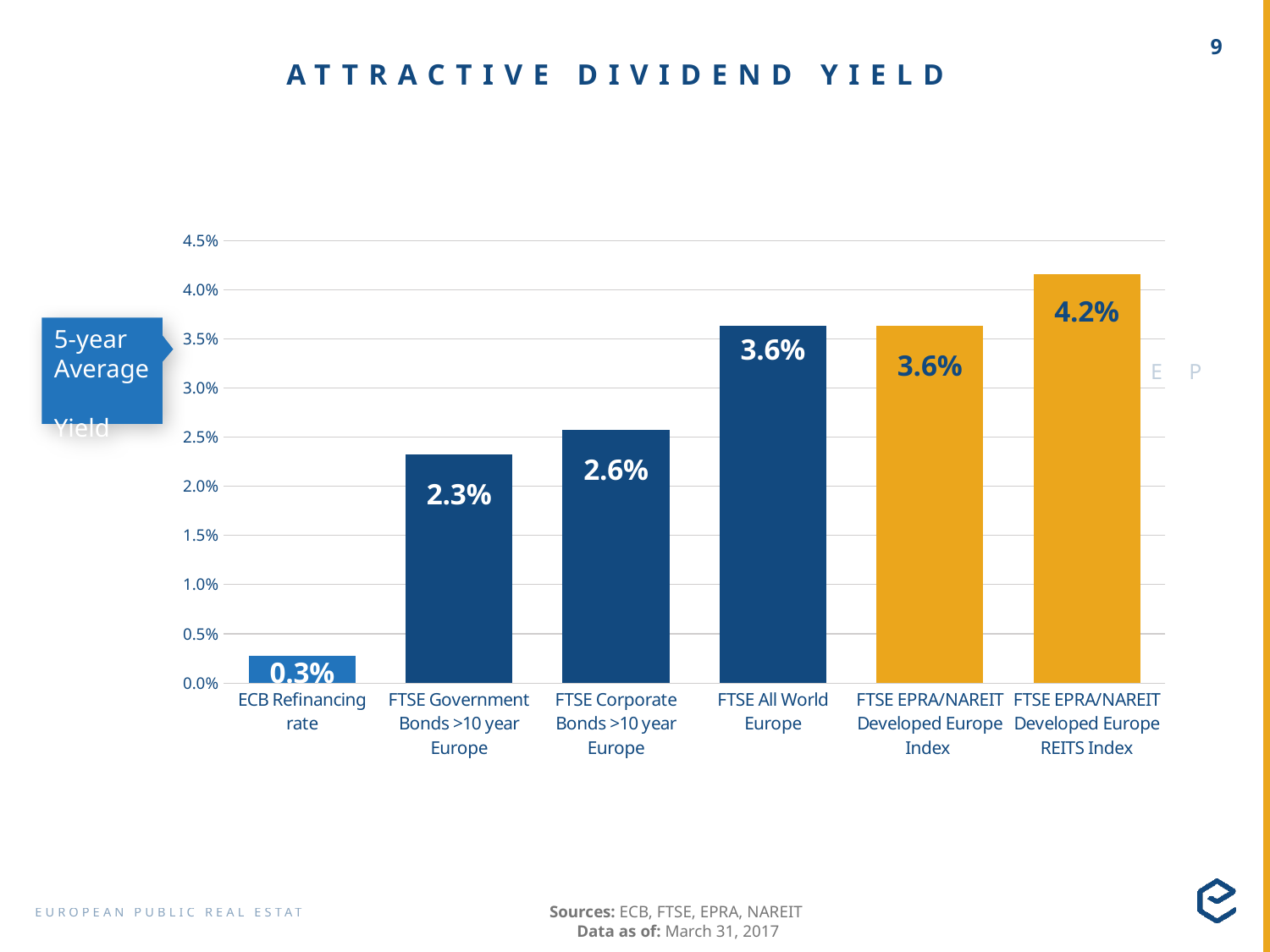
Which category has the highest value? FTSE EPRA/NAREIT Developed Europe REITS Index What is the value for FTSE Corporate Bonds >10 year Europe? 2.6% How many categories are shown in the chart? 6 Which category has the lowest value? ECB Refinancing rate What is the title of the slide? ATTRACTIVE DIVIDEND YIELD What kind of chart is shown on the slide? bar chart What is the value for FTSE EPRA/NAREIT Developed Europe REITS Index? 4.2% Which is larger, the value for FTSE Government Bonds >10 year Europe or the value for FTSE All World Europe? FTSE All World Europe What is the value for ECB Refinancing rate? 0.3% What is the difference between the values for FTSE EPRA/NAREIT Developed Europe REITS Index and FTSE Corporate Bonds >10 year Europe? 1.6% What is the value for FTSE Government Bonds >10 year Europe? 2.3% Is the value for FTSE All World Europe greater or less than 3.0%? greater